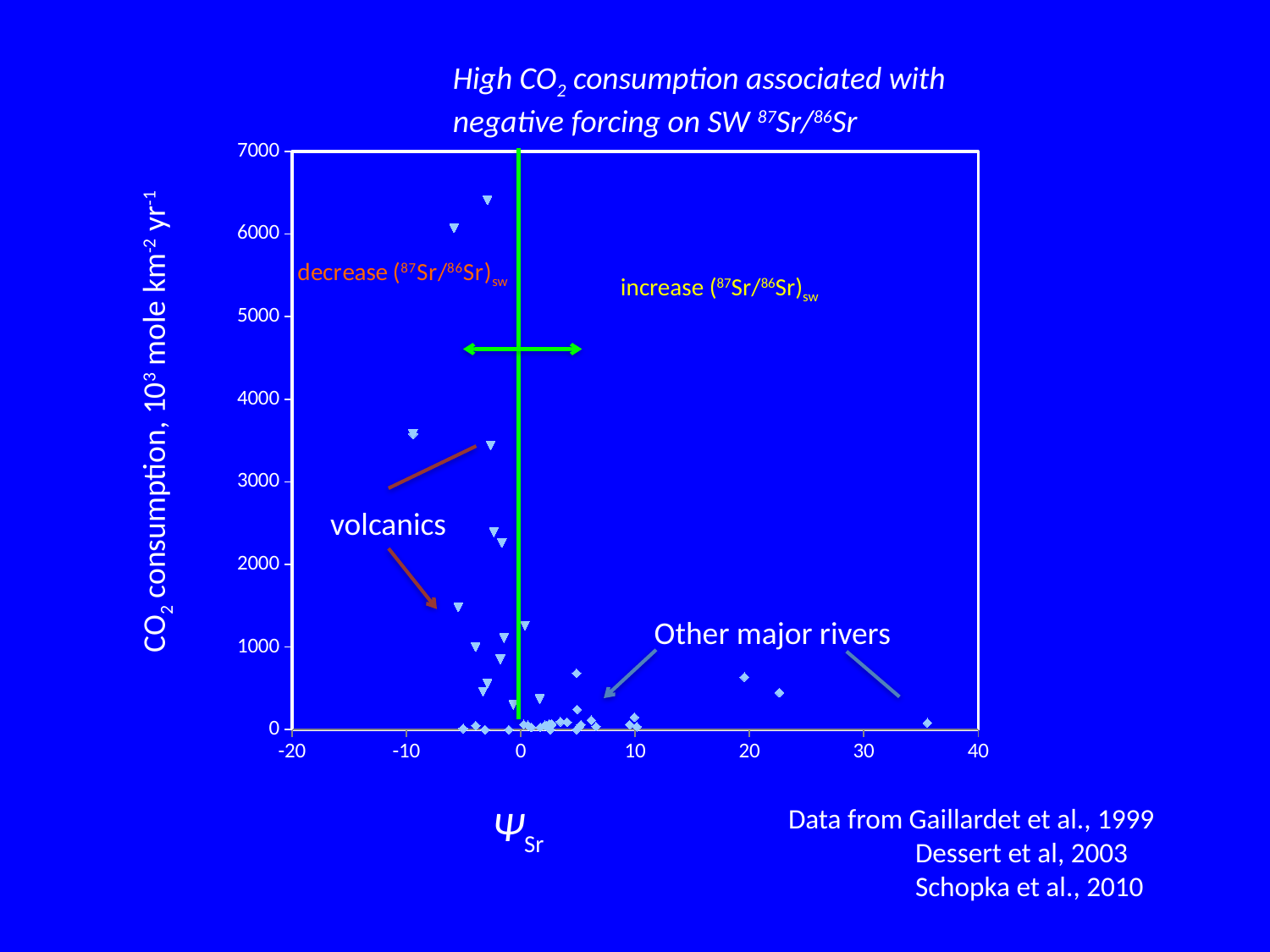
Is the 'Other major rivers' data point near Ψ_Sr = 35 greater or less than 1000 on the CO2 consumption axis? less Is the 'Other major rivers' data point near Ψ_Sr = 20 greater or less than 1000 on the CO2 consumption axis? less Which group of points reaches higher CO2 consumption values, volcanics or other major rivers? volcanics Is the highest volcanics data point greater or less than 6000 on the CO2 consumption axis? greater What is the range of the x axis (Ψ_Sr) on the chart? -20 to 40 How many groups of data points are labelled on the chart? 2 Do the volcanics data points lie mostly to the left or to the right of the green vertical line at Ψ_Sr = 0? left What is the maximum value shown on the y axis of the chart? 7000 What kind of chart is shown on the slide? scatter plot